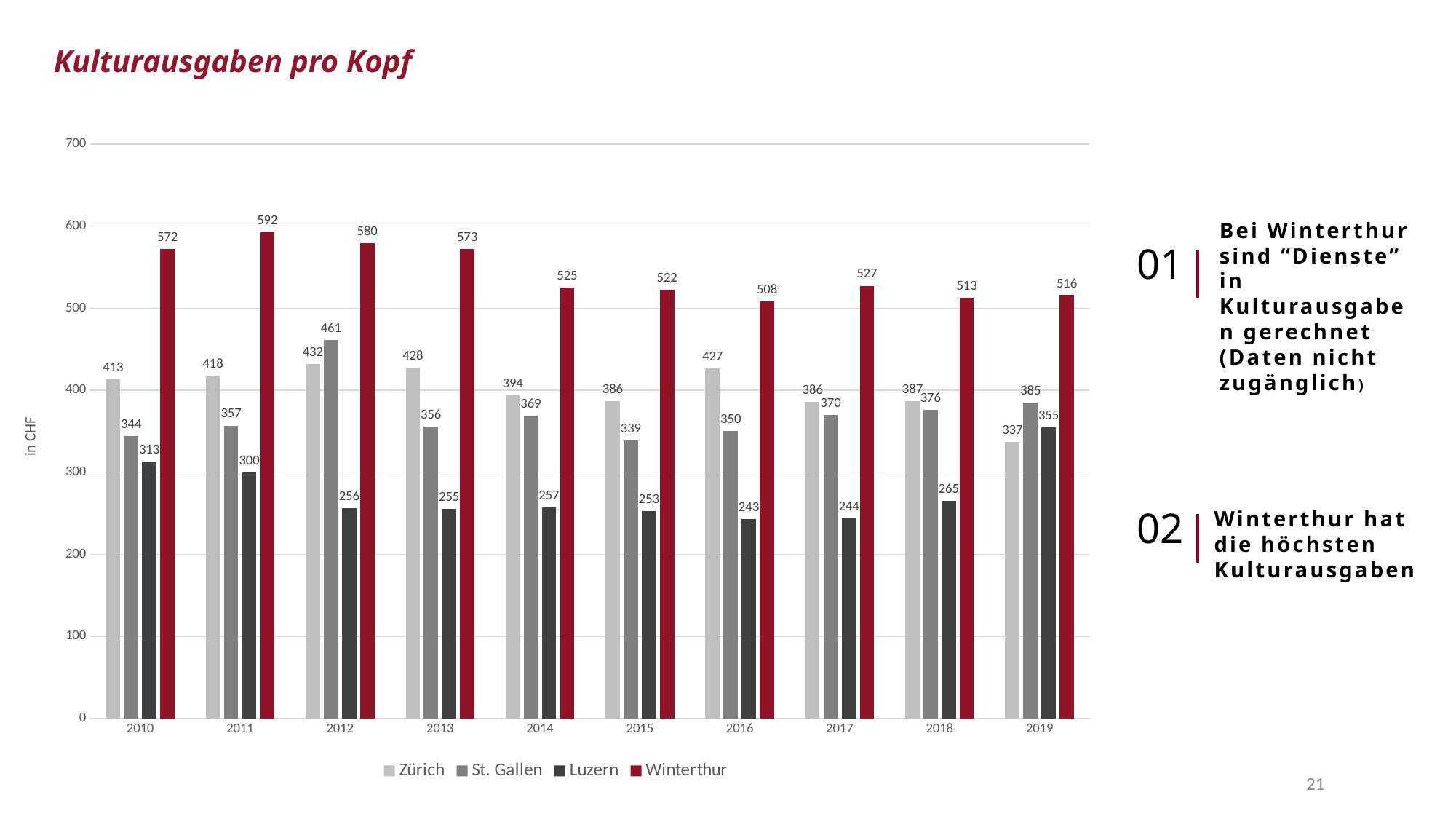
How many years are shown on the x axis? 10 In 2012, which is larger: the value for Zürich or for St. Gallen? St. Gallen Does the value for Winterthur rise or fall from 2011 to 2016? fall What is the difference between the Winterthur and Zürich values in 2010? 159 By how much did the Zürich value fall from 2010 to 2019? 76 In which year is the value for Luzern the lowest? 2016 What is the value for St. Gallen in 2019? 385 In which year is the value for Winterthur the highest? 2011 What kind of chart is shown on the slide? bar chart What is the value for Winterthur in 2011? 592 How many series does the legend list? 4 What is the value for Luzern in 2016? 243